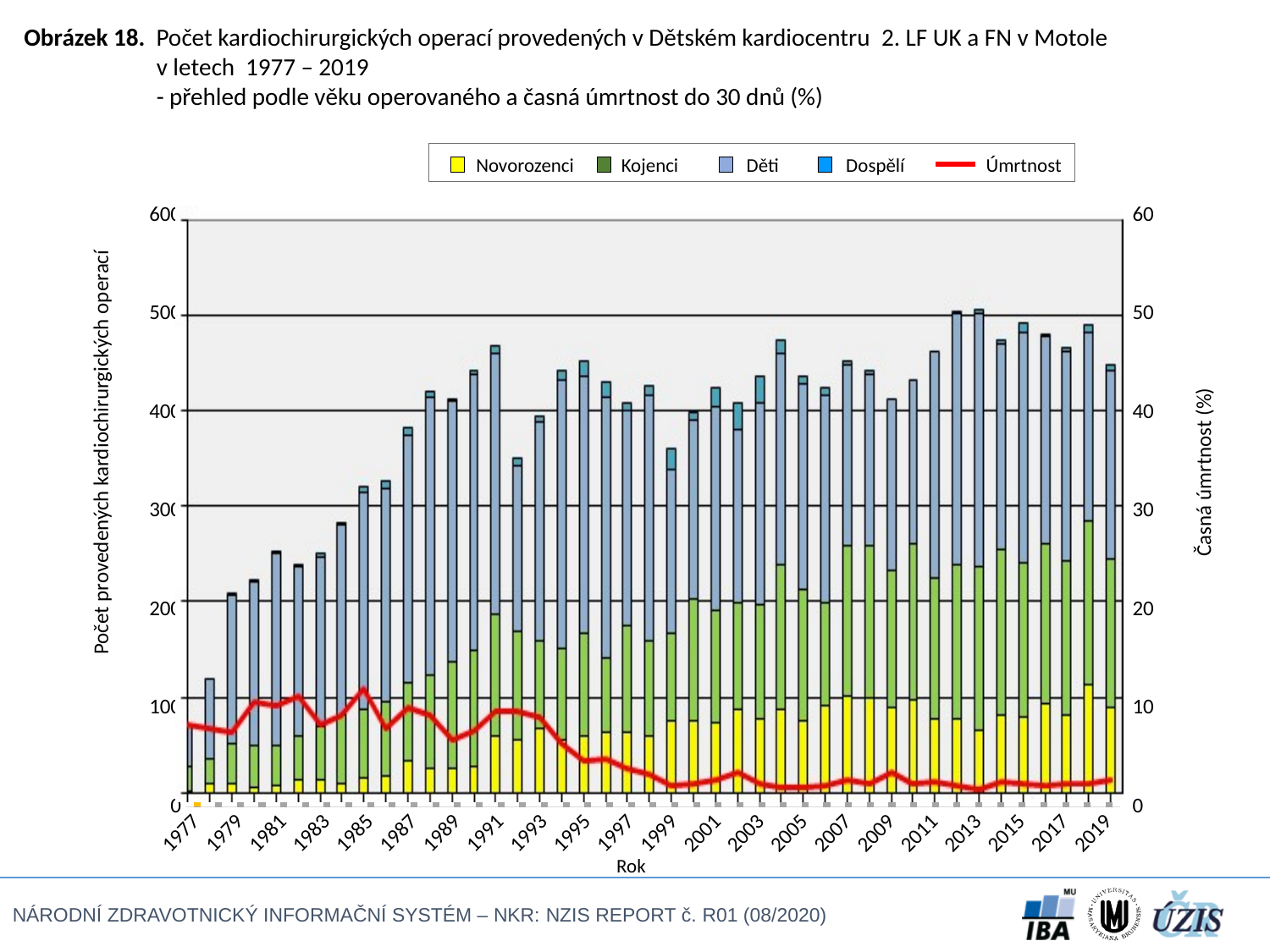
What kind of chart is shown on the slide? A stacked bar chart combined with a line What colour is the Úmrtnost line? Red Which year has the lowest total number of operations? 1977 Does the Úmrtnost line overall rise or fall from 1977 to 2019? fall What is the title of the right-hand vertical axis? Časná úmrtnost (%) Is the total number of operations in 1983 greater or less than 300? less Is the total number of operations in 1991 greater or less than 400? greater How many series does the legend list? 5 Is the Úmrtnost value in 2019 greater or less than 10? less Which year has the larger total number of operations, 1978 or 1991? 1991 How many years (bars) are plotted on the x axis, from 1977 to 2019? 43